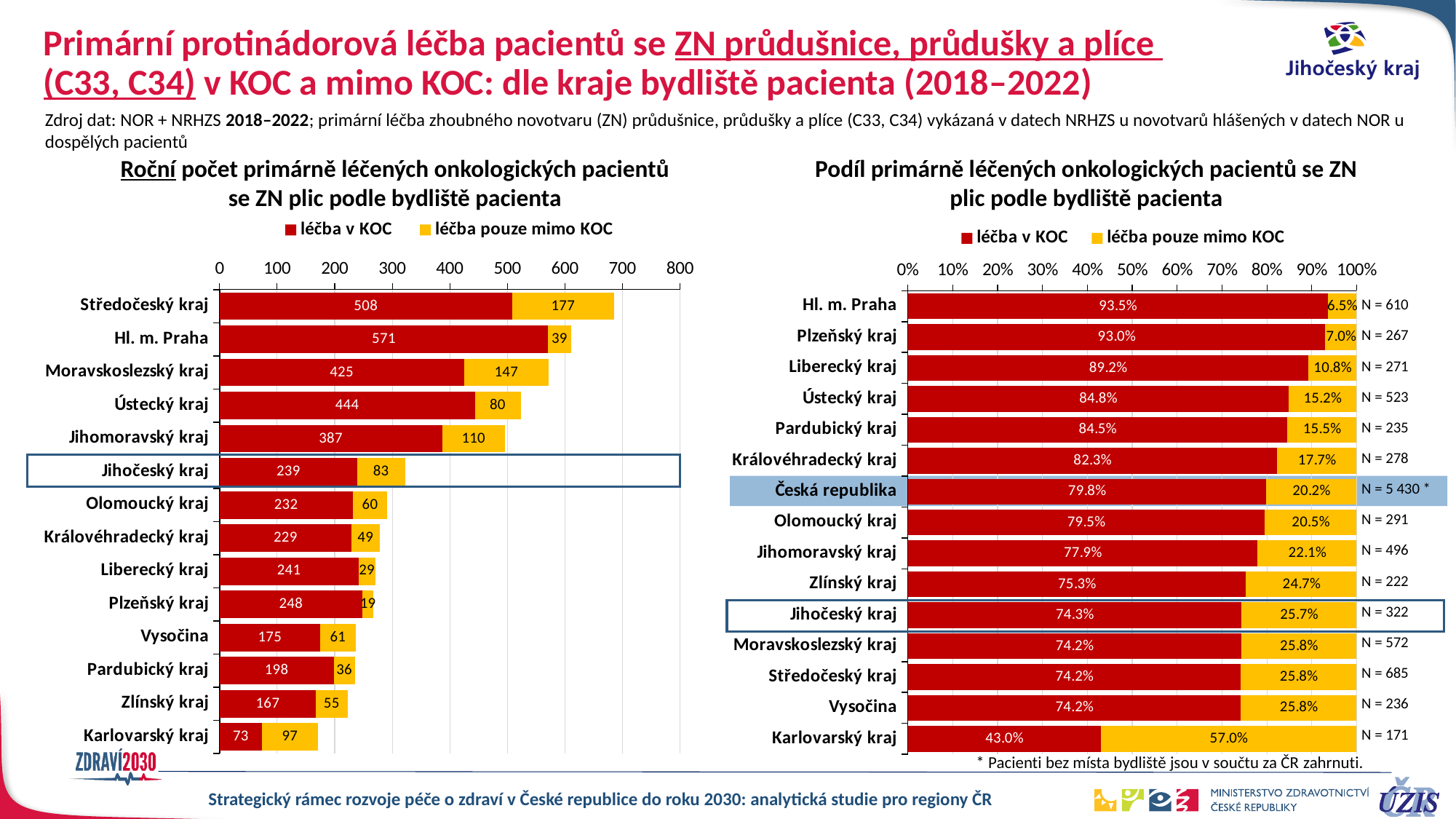
In the left chart (Roční počet primárně léčených onkologických pacientů), what is the total of the stacked bar for Moravskoslezský kraj? 572 In the left chart (Roční počet primárně léčených onkologických pacientů), how many regions are shown? 14 In the left chart (Roční počet primárně léčených onkologických pacientů), which region has the lowest value for 'léčba v KOC'? Karlovarský kraj In the right chart (Podíl primárně léčených onkologických pacientů), what is the share of 'léčba pouze mimo KOC' for Karlovarský kraj? 57.0% In the left chart (Roční počet primárně léčených onkologických pacientů), what is the value of 'léčba v KOC' for Jihočeský kraj? 239 In the left chart (Roční počet primárně léčených onkologických pacientů), what is the difference between 'léčba v KOC' for Ústecký kraj and Jihomoravský kraj? 57 What type of chart is the left chart (Roční počet primárně léčených onkologických pacientů)? stacked bar chart In the left chart (Roční počet primárně léčených onkologických pacientů), what is the value of 'léčba pouze mimo KOC' for Středočeský kraj? 177 In the left chart (Roční počet primárně léčených onkologických pacientů), which region has the highest value for 'léčba v KOC'? Hl. m. Praha In the right chart (Podíl primárně léčených onkologických pacientů), what is the share of 'léčba v KOC' for Hl. m. Praha? 93.5% In the right chart (Podíl primárně léčených onkologických pacientů), is the share of 'léčba v KOC' for Jihočeský kraj larger or smaller than for Česká republika? smaller In the right chart (Podíl primárně léčených onkologických pacientů), which region has the lowest share of 'léčba v KOC'? Karlovarský kraj